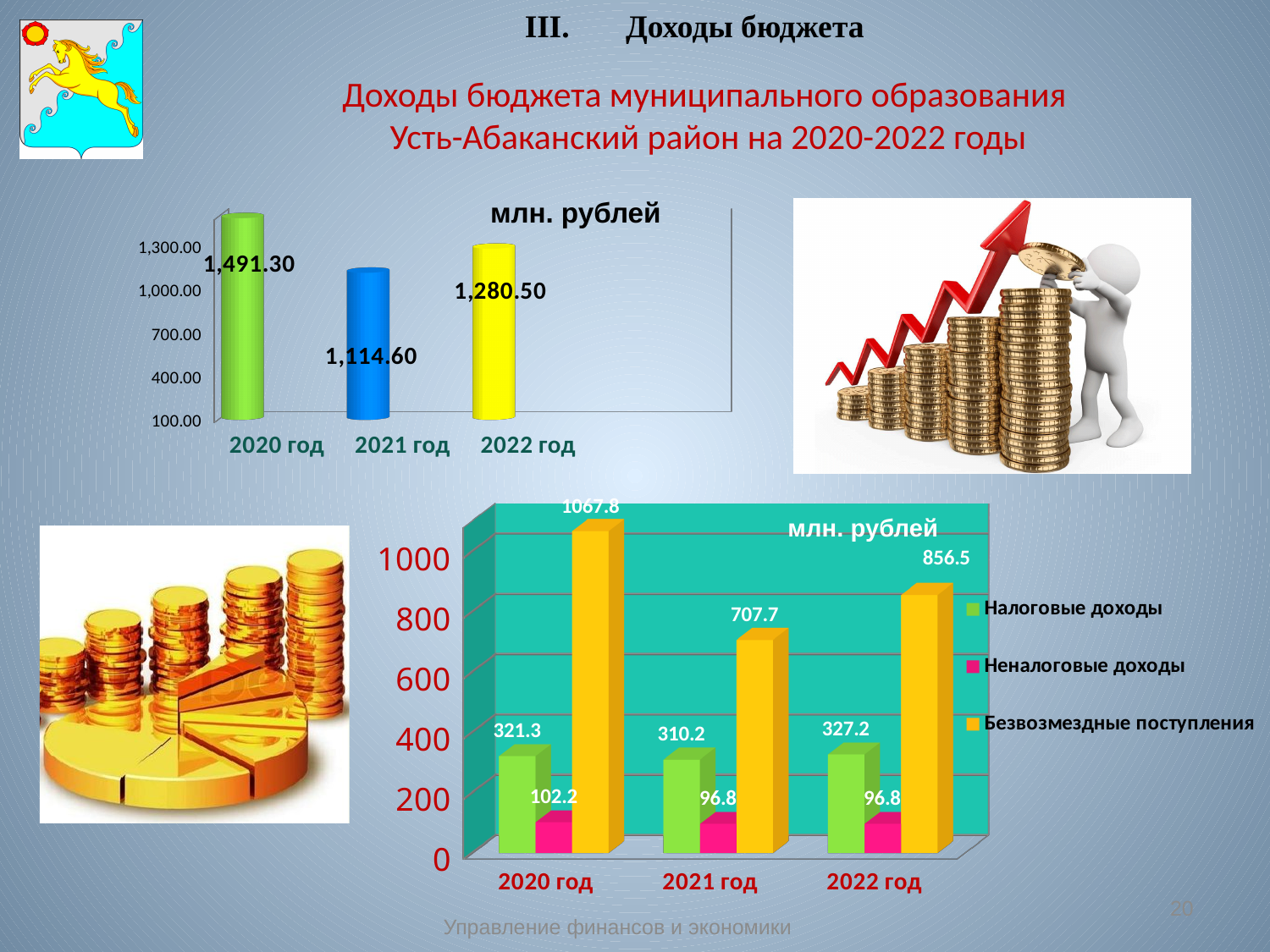
In the top-left chart, how many years are shown? 3 What type of chart is the bottom chart? Bar chart In the bottom chart, how many series does the legend list? 3 In the bottom chart, what is the value of Налоговые доходы for 2022 год? 327.2 In the top-left chart, what is the value for 2021 год? 1,114.60 In the bottom chart, what is the value of Безвозмездные поступления for 2021 год? 707.7 In the top-left chart, which year has the lowest value? 2021 год In the top-left chart, what is the value for 2020 год? 1,491.30 In the bottom chart, which year has the highest value of Безвозмездные поступления? 2020 год In the bottom chart, what is the difference between Безвозмездные поступления for 2022 год and 2021 год? 148.8 In the top-left chart, what is the difference between the values for 2020 год and 2022 год? 210.80 In the top-left chart, which year has the highest value? 2020 год